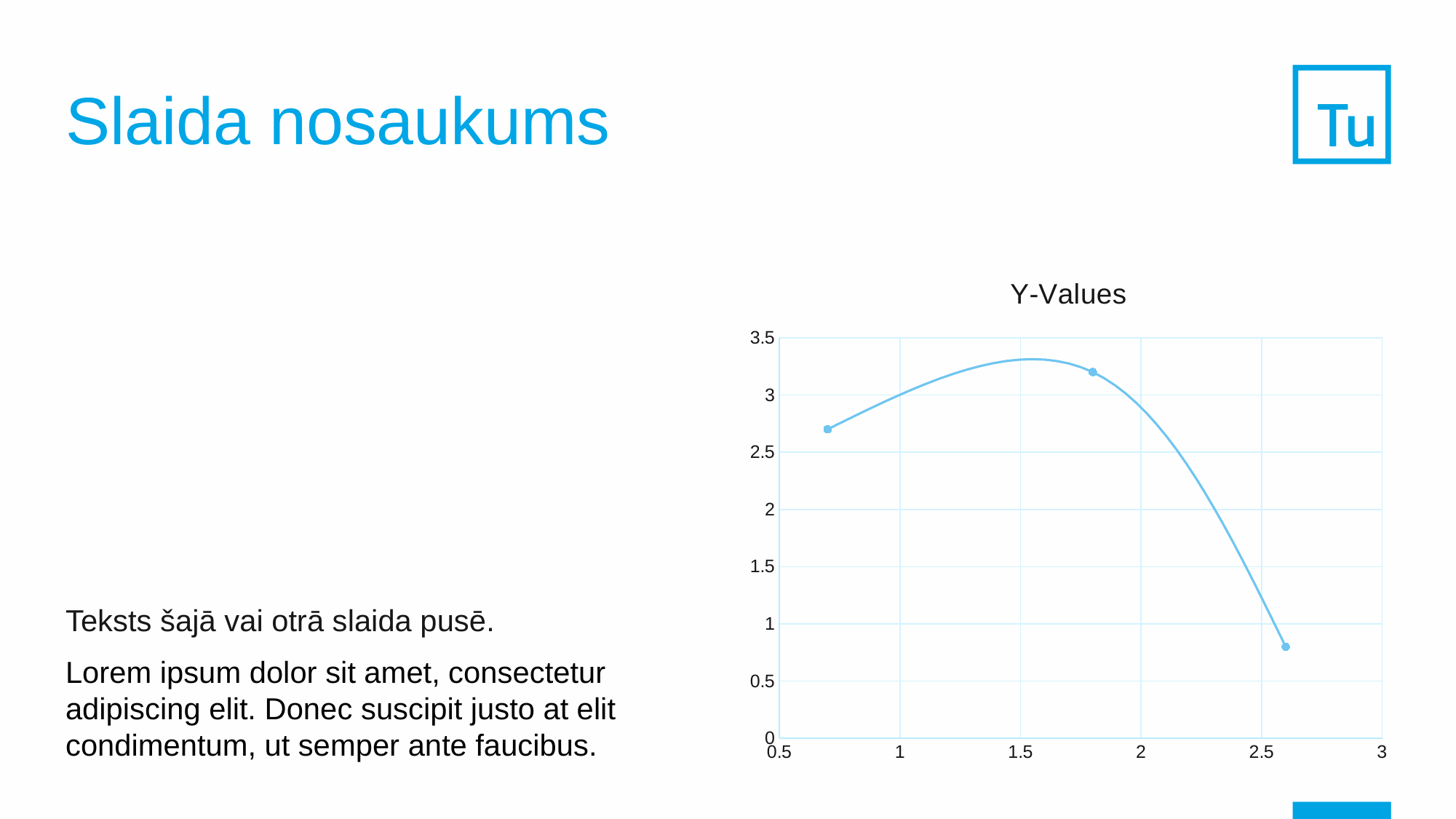
Which is larger, the value of the first data point or the value of the last data point? the first data point Which data point has the lowest value: the first, the middle, or the last? the last What is the title of the chart? Y-Values What is the highest value shown on the vertical axis? 3.5 How many data points are plotted on the chart? 3 Is the value of the middle data point greater or less than 3? greater Is the value of the last (rightmost) data point greater or less than 1? less How do the values change along the x axis? they rise, then fall Is the value of the first (leftmost) data point greater or less than 2.5? greater What kind of chart is shown on the slide? line chart Which data point has the highest value: the first, the middle, or the last? the middle